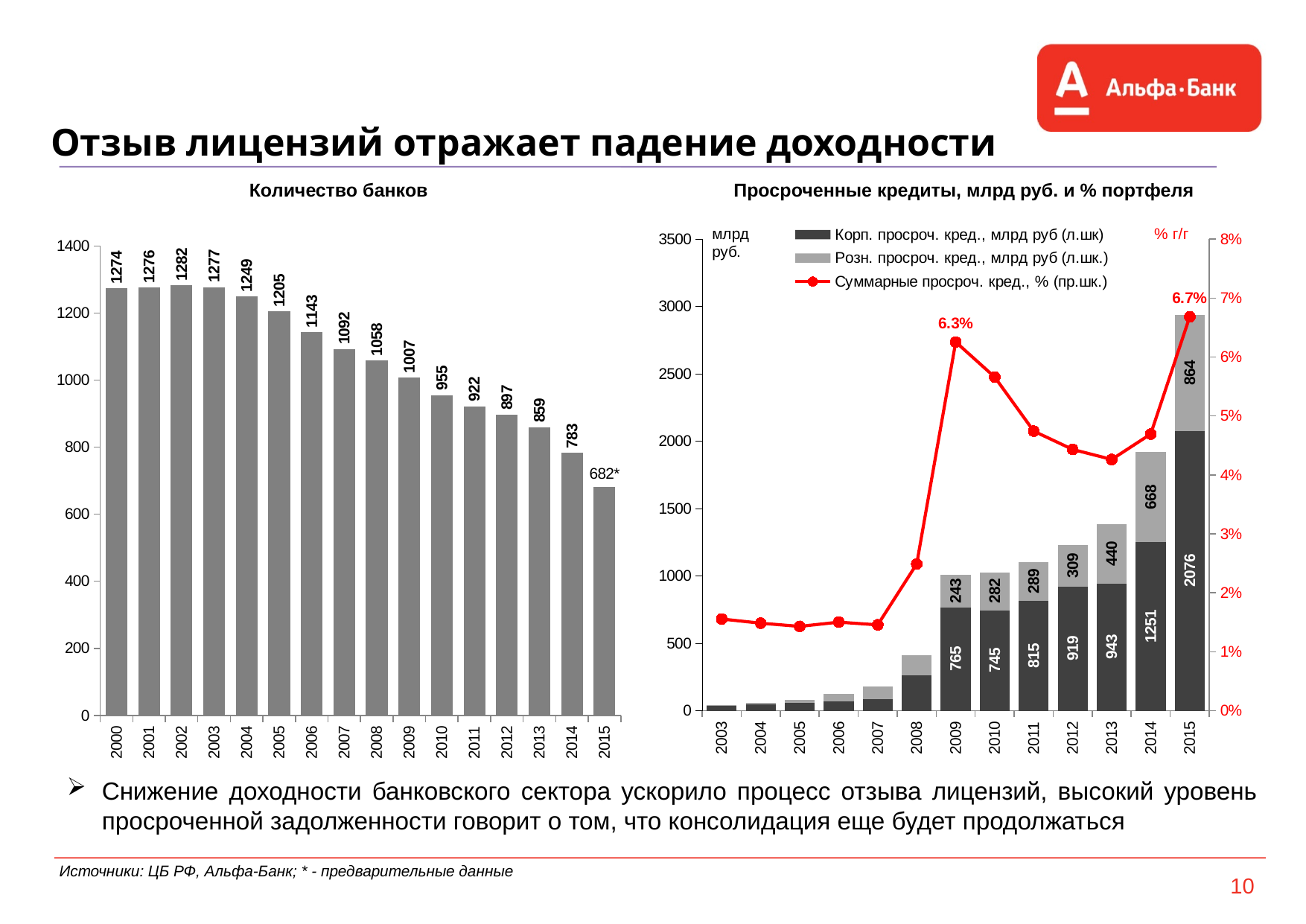
In the 'Просроченные кредиты' chart, what is the value of 'Розн. просроч. кред.' for 2013? 440 In the 'Просроченные кредиты' chart, what is the value of 'Корп. просроч. кред.' for 2015? 2076 In the 'Количество банков' chart, what is the value for 2002? 1282 What kind of chart is the 'Количество банков' chart? bar chart In the 'Количество банков' chart, which year has the highest number of banks? 2002 In the 'Количество банков' chart, do the values rise or fall from 2004 to 2015? fall In the 'Просроченные кредиты' chart, what is the total of the stacked bar for 2014? 1919 How many series does the legend of the 'Просроченные кредиты' chart list? 3 How many years are shown in the 'Количество банков' chart? 16 In the 'Количество банков' chart, which year has the lowest value? 2015 In the 'Просроченные кредиты' chart, what is the labelled value of 'Суммарные просроч. кред., %' for 2009? 6.3% In the 'Количество банков' chart, what is the difference between the values for 2014 and 2015? 101